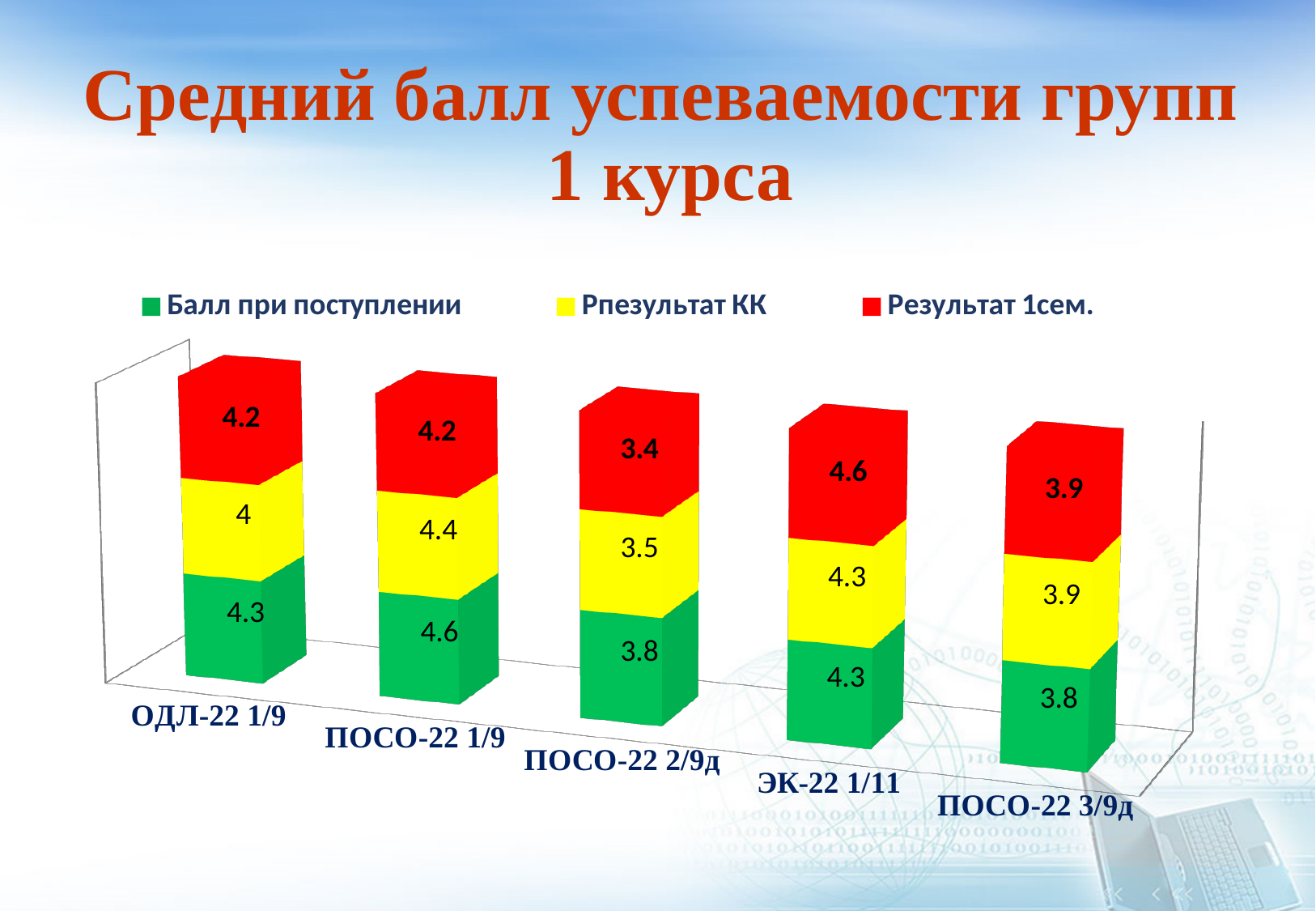
What is the value of "Результат 1сем." for ЭК-22 1/11? 4.6 What is the total of the stacked bar for ПОСО-22 2/9д? 10.7 What is the difference between "Балл при поступлении" and "Результат 1сем." for ПОСО-22 2/9д? 0.4 What is the value of "Балл при поступлении" for ПОСО-22 1/9? 4.6 Which group has the lowest value for "Результат 1сем."? ПОСО-22 2/9д Which is larger for ПОСО-22 1/9: "Балл при поступлении" or "Результат 1сем."? Балл при поступлении How many series does the legend list? 3 What is the value of "Рпезультат КК" for ПОСО-22 3/9д? 3.9 What kind of chart is shown on the slide? Stacked bar chart Which group has the highest value for "Результат 1сем."? ЭК-22 1/11 How many groups are shown on the x axis? 5 What is the value of "Рпезультат КК" for ОДЛ-22 1/9? 4